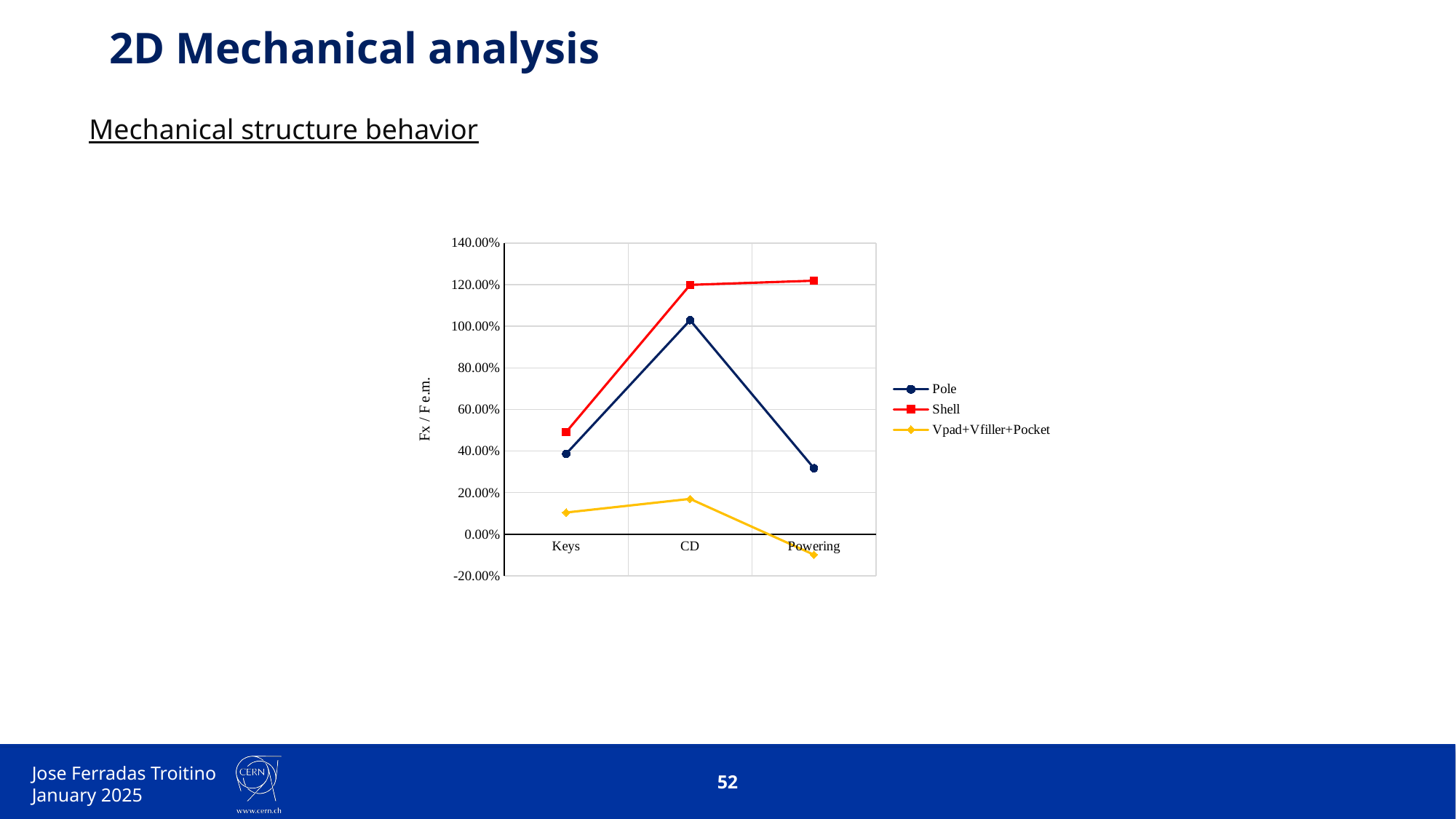
What is the label on the vertical axis? Fx / F e.m. Which is larger, the Pole value at Keys or the Pole value at Powering? Keys Which series has the highest value at CD? Shell Which series has the lowest value at Powering? Vpad+Vfiller+Pocket Is the value for Shell at Keys greater or less than 60.00%? less At which category does the Pole series reach its highest value? CD How many categories are shown on the x axis? 3 Does the Pole series rise or fall from CD to Powering? fall Is the value for Pole at CD greater or less than 100.00%? greater How many series does the legend list? 3 What kind of chart is shown on the slide? line chart Is the value for Vpad+Vfiller+Pocket at Powering greater or less than 0.00%? less